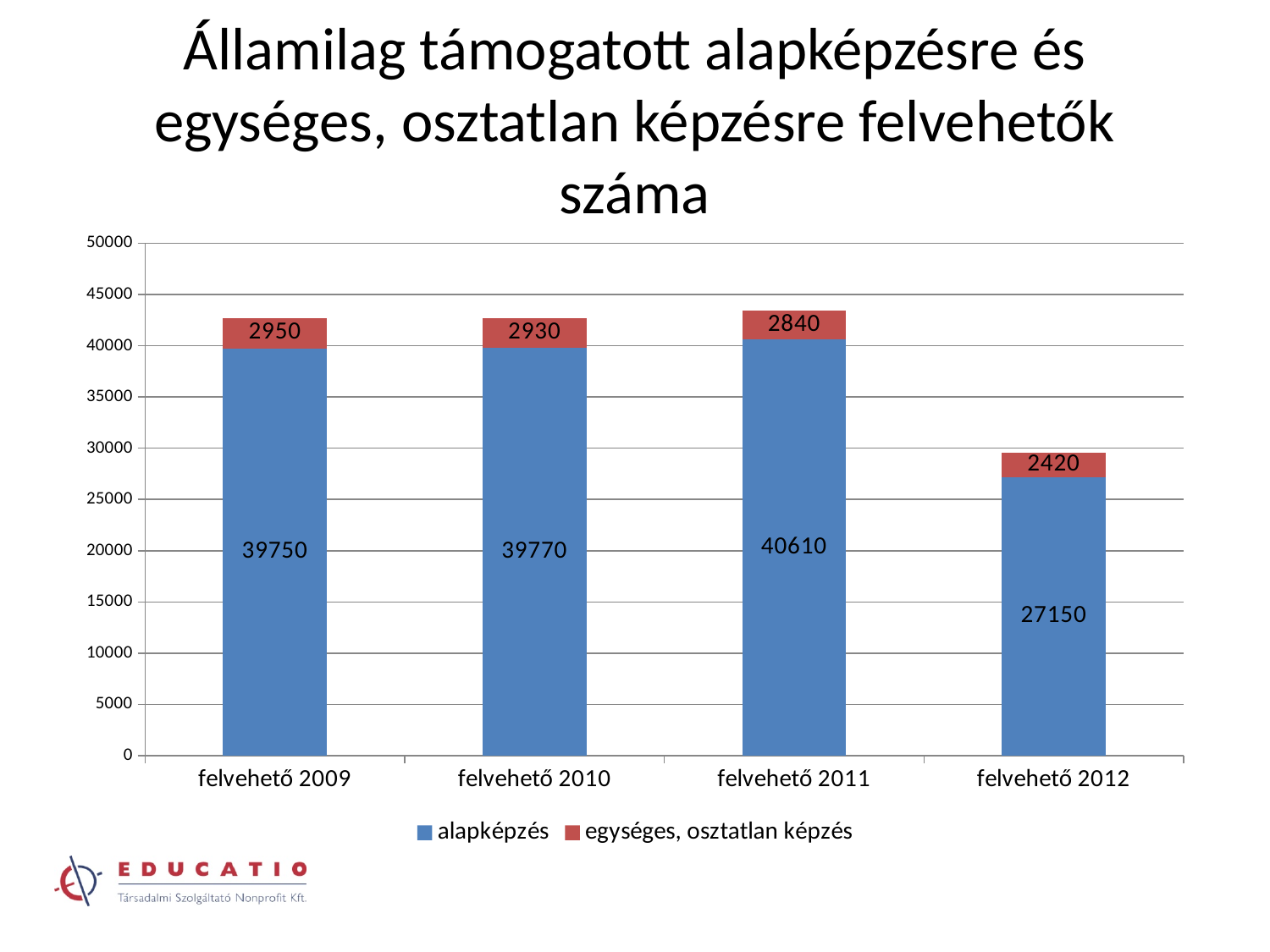
Which is larger, the egységes, osztatlan képzés value for felvehető 2009 or for felvehető 2011? felvehető 2009 What kind of chart is shown on the slide? stacked bar chart Which category has the lowest value for egységes, osztatlan képzés? felvehető 2012 What is the value for egységes, osztatlan képzés in felvehető 2012? 2420 What is the value for alapképzés in felvehető 2011? 40610 How many series does the legend list? 2 What is the total of the stacked bar for felvehető 2012? 29570 What is the value for alapképzés in felvehető 2009? 39750 What is the difference between the alapképzés values for felvehető 2011 and felvehető 2012? 13460 What is the total of the stacked bar for felvehető 2011? 43450 Which category has the highest value for alapképzés? felvehető 2011 How many categories are shown on the x axis? 4